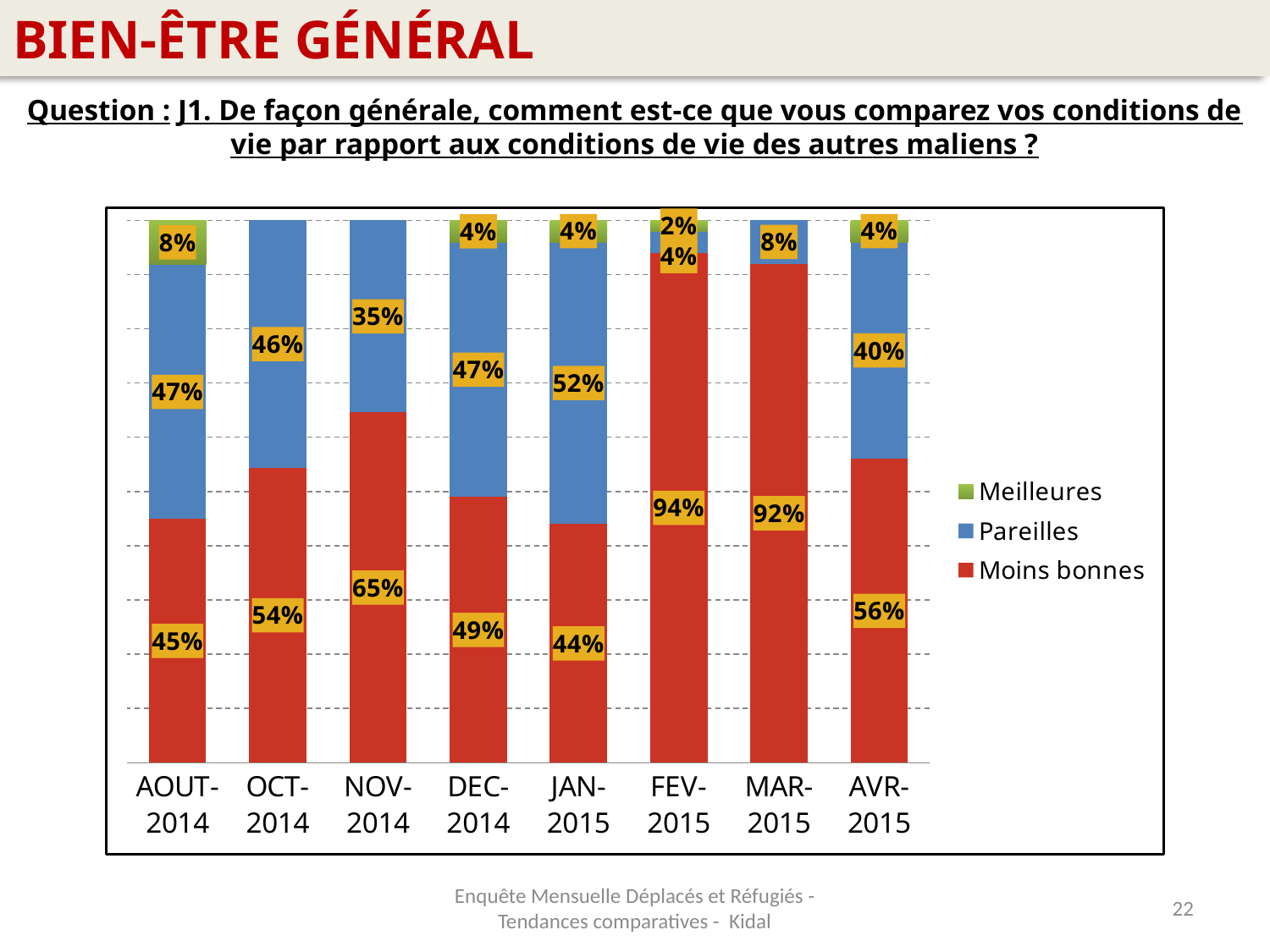
What kind of chart is shown on the slide? Stacked bar chart What is the value for "Moins bonnes" in NOV-2014? 65% How many months are shown on the x axis of the chart? 8 Which is larger in OCT-2014: the "Moins bonnes" share or the "Pareilles" share? Moins bonnes Which colour represents the "Pareilles" series in the chart? Blue What is the value for "Pareilles" in JAN-2015? 52% How many series does the legend list? 3 What is the difference between the "Moins bonnes" values for MAR-2015 and AVR-2015? 36% In which month is the "Pareilles" share the lowest? FEV-2015 In which month is the "Moins bonnes" share the highest? FEV-2015 What percentage of respondents answered "Moins bonnes" in FEV-2015? 94% What is the value for "Meilleures" in AOUT-2014? 8%